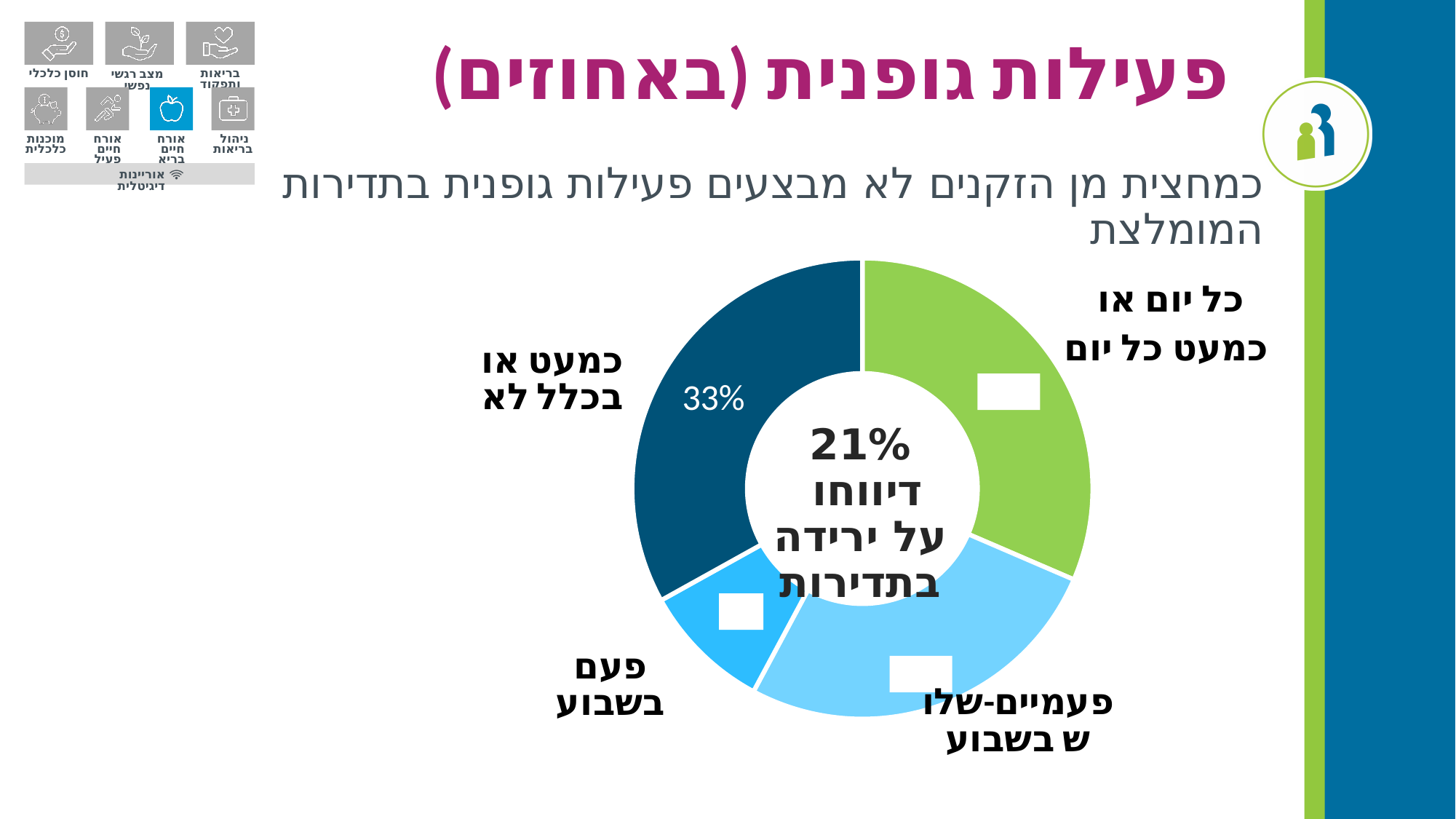
Which slice is larger: "פעם בשבוע" or "כמעט או בכלל לא"? כמעט או בכלל לא How many categories (slices) does the chart have? 4 What percentage is shown for the "כמעט או בכלל לא" slice? 33% Which slice is larger: "פעם בשבוע" or "פעמיים-שלוש בשבוע"? פעמיים-שלוש בשבוע What is the title of the slide? פעילות גופנית (באחוזים) What kind of chart is shown on the slide? Donut (pie) chart What percentage is written in the center of the donut chart? 21% Which category has the smallest slice in the chart? פעם בשבוע